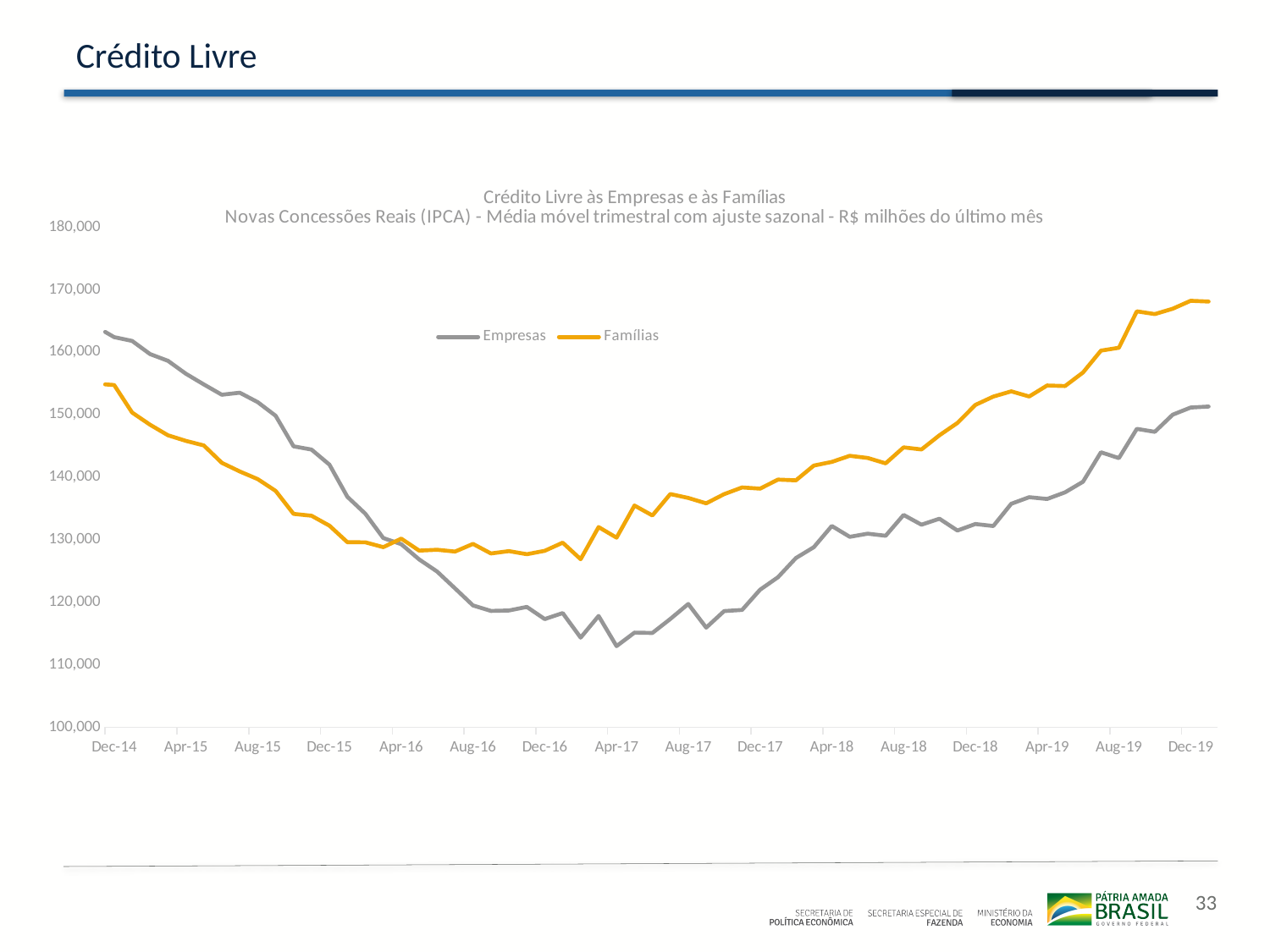
Is the value for Famílias at Dec-14 greater or less than 160,000? less What kind of chart is shown on the slide? line chart How many series does the legend list? 2 Is the value for Famílias at Dec-19 greater or less than 160,000? greater What are the two series named in the legend? Empresas and Famílias At Dec-19, which series has the higher value, Empresas or Famílias? Famílias Does the Famílias line rise or fall between Apr-17 and Dec-19? rise Is the value for Empresas at Apr-17 greater or less than 120,000? less At Dec-14, which series has the higher value, Empresas or Famílias? Empresas What is the first line of the chart title? Crédito Livre às Empresas e às Famílias Does the Empresas line rise or fall between Dec-14 and Apr-17? fall